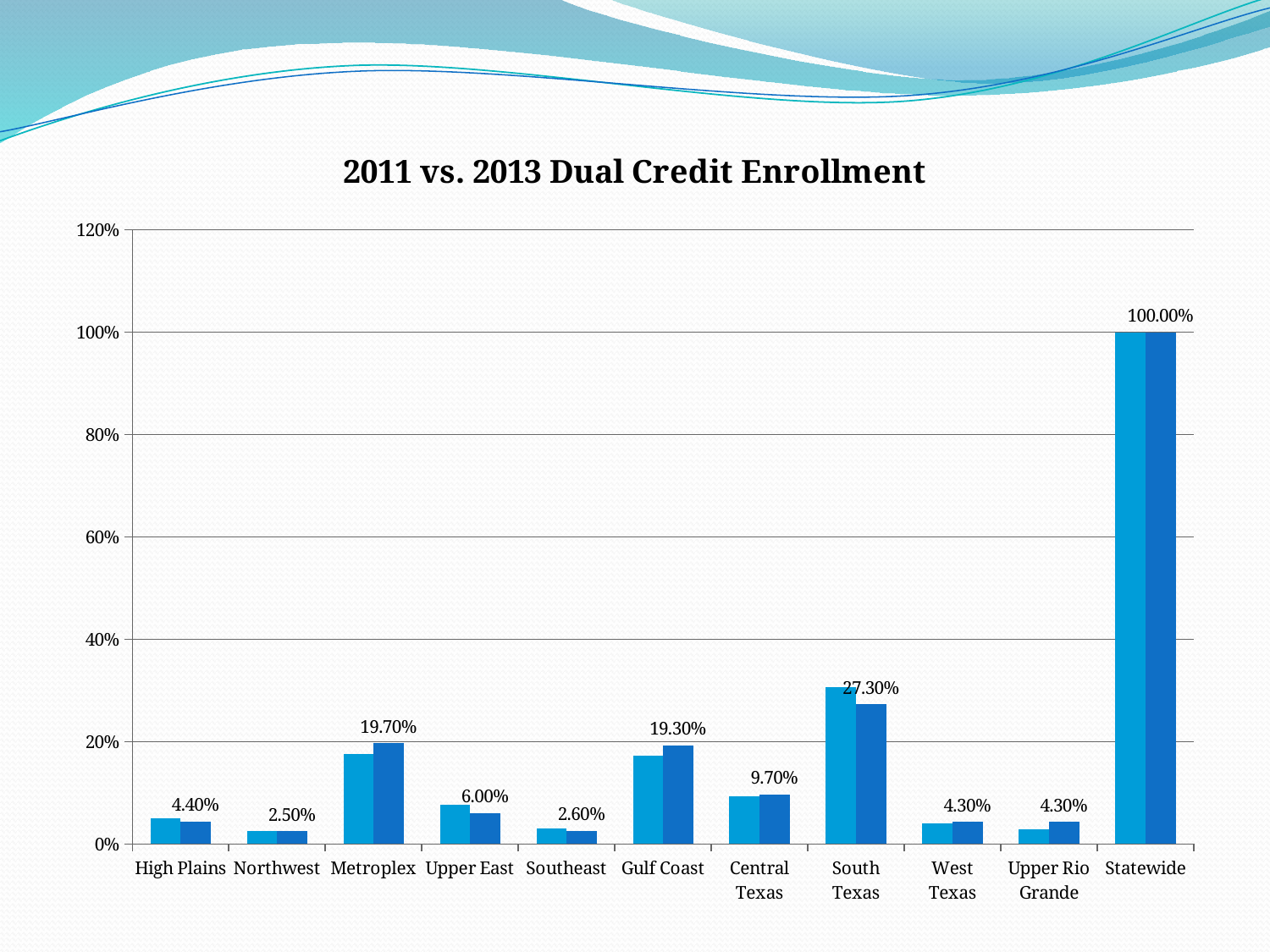
What is the data label shown for Central Texas? 9.70% Which category has the lowest labeled value? Northwest What is the title of the chart? 2011 vs. 2013 Dual Credit Enrollment What is the data label shown for Metroplex? 19.70% How many categories are shown on the x axis? 11 What is the data label shown for Northwest? 2.50% What is the difference between the labeled values for South Texas and Central Texas? 17.60% Which category has the highest labeled value? Statewide Is the value of the lighter blue bar for South Texas greater or less than 20%? greater Which has the larger labeled value, Metroplex or Upper East? Metroplex What kind of chart is shown on the slide? Bar chart What is the data label shown for South Texas? 27.30%